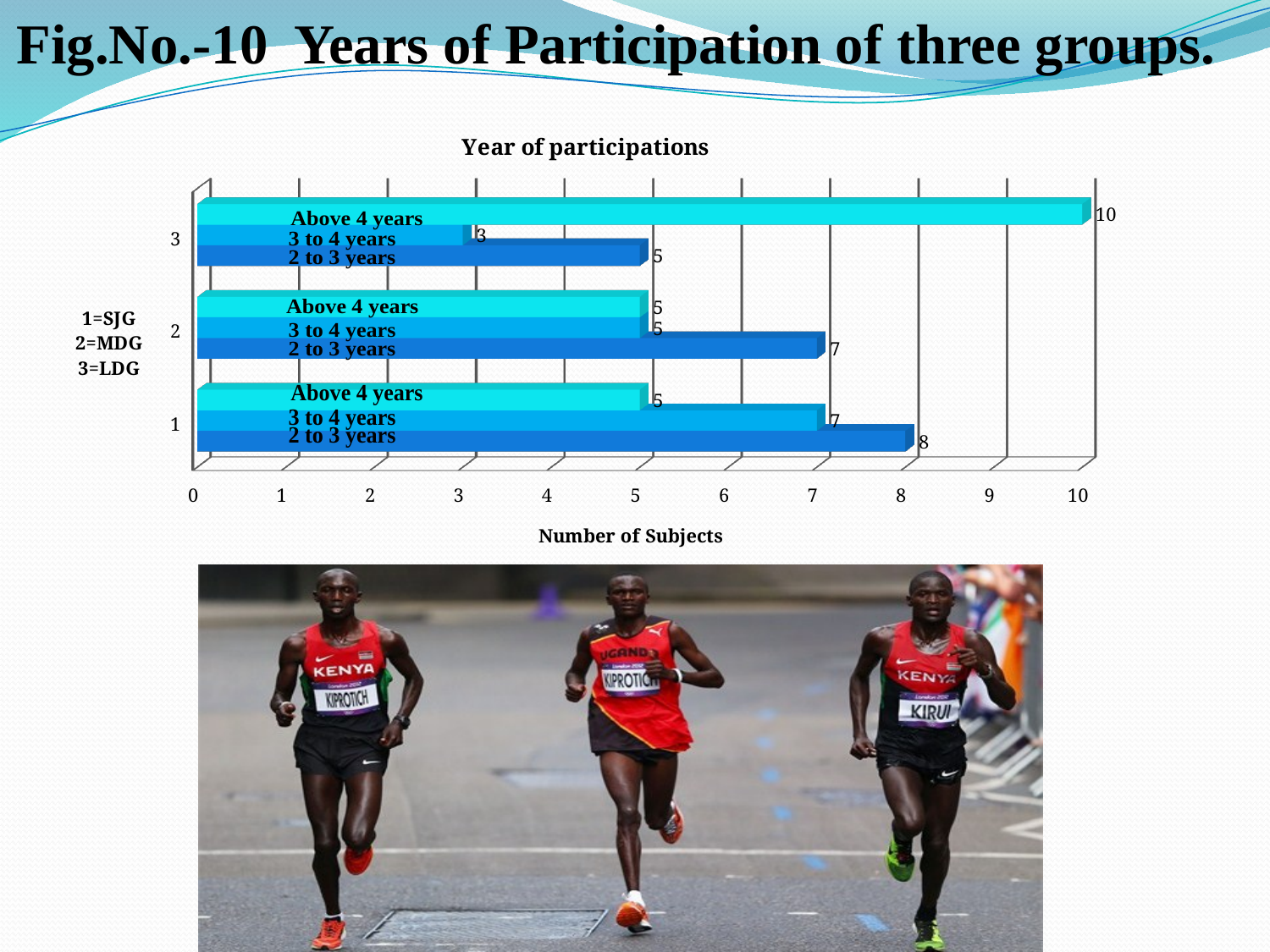
What is the title of the chart? Year of participations How many groups are shown on the y-axis of the chart? 3 What is the value for '3 to 4 years' in group 3? 3 What is the value for '2 to 3 years' in group 2? 7 What is the x-axis label of the chart? Number of Subjects What is the value for '2 to 3 years' in group 1? 8 Which bar has the lowest value in the chart? 3 to 4 years in group 3 Which bar has the highest value in the chart? Above 4 years in group 3 Which is larger in group 1: '3 to 4 years' or 'Above 4 years'? 3 to 4 years What is the difference between 'Above 4 years' and '3 to 4 years' in group 3? 7 What is the value for 'Above 4 years' in group 3? 10 What type of chart is shown on the slide? bar chart